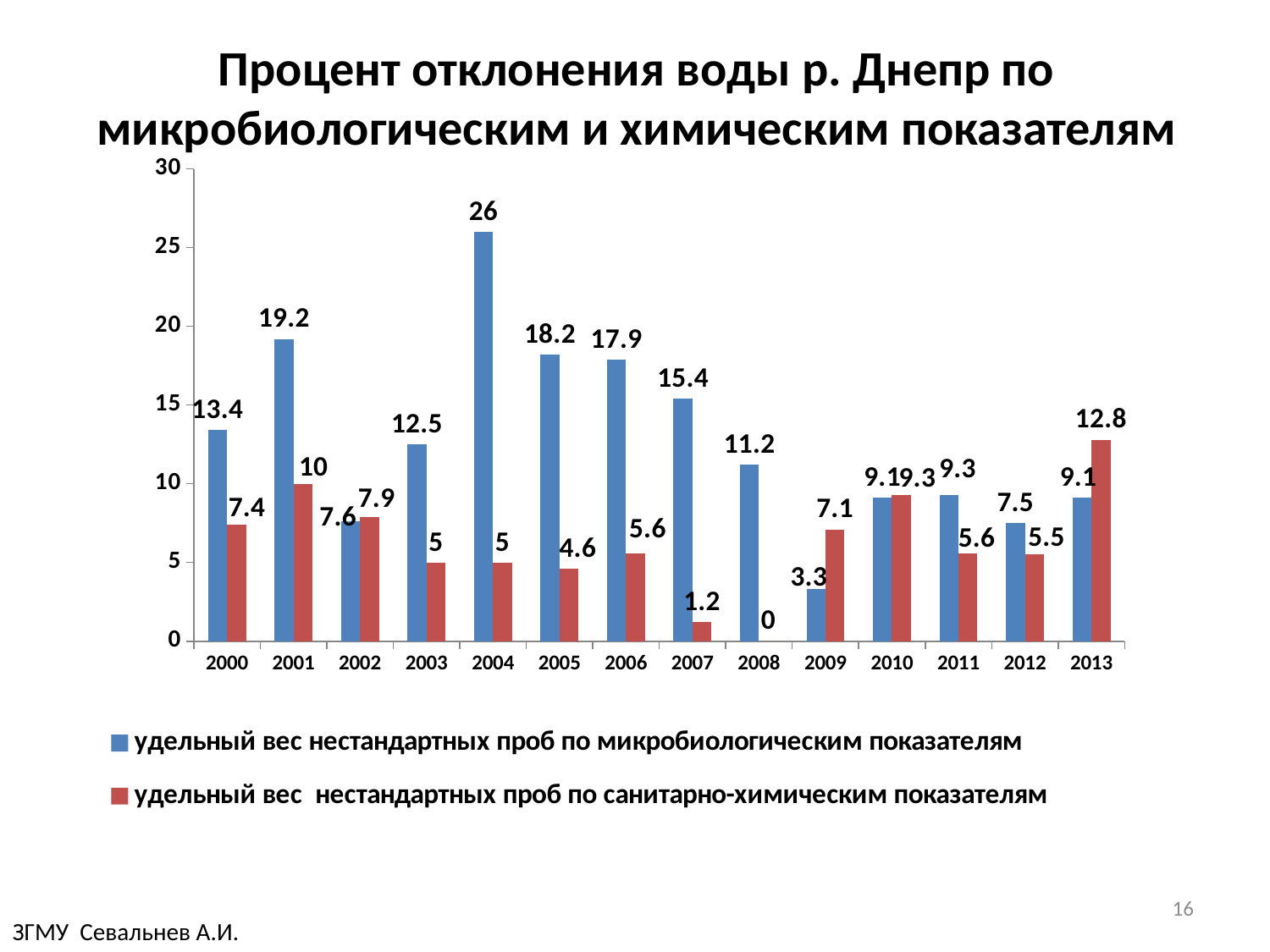
How many series does the legend list? 2 What is the value for 2013 in the series 'удельный вес нестандартных проб по санитарно-химическим показателям'? 12.8 In which year is the value for 'удельный вес нестандартных проб по микробиологическим показателям' the highest? 2004 In which year is the value for 'удельный вес нестандартных проб по санитарно-химическим показателям' the highest? 2013 In which year is the value for 'удельный вес нестандартных проб по санитарно-химическим показателям' the lowest? 2008 How many years are shown on the x axis of the chart? 14 In 2013, which series has the larger value: microbiological or sanitary-chemical? sanitary-chemical (удельный вес нестандартных проб по санитарно-химическим показателям) What is the value for 2004 in the series 'удельный вес нестандартных проб по микробиологическим показателям'? 26 What is the difference between the microbiological values for 2004 and 2005? 7.8 What kind of chart is shown on the slide? bar chart What is the difference between the microbiological and sanitary-chemical values in 2001? 9.2 What is the value for 2009 in the series 'удельный вес нестандартных проб по микробиологическим показателям'? 3.3